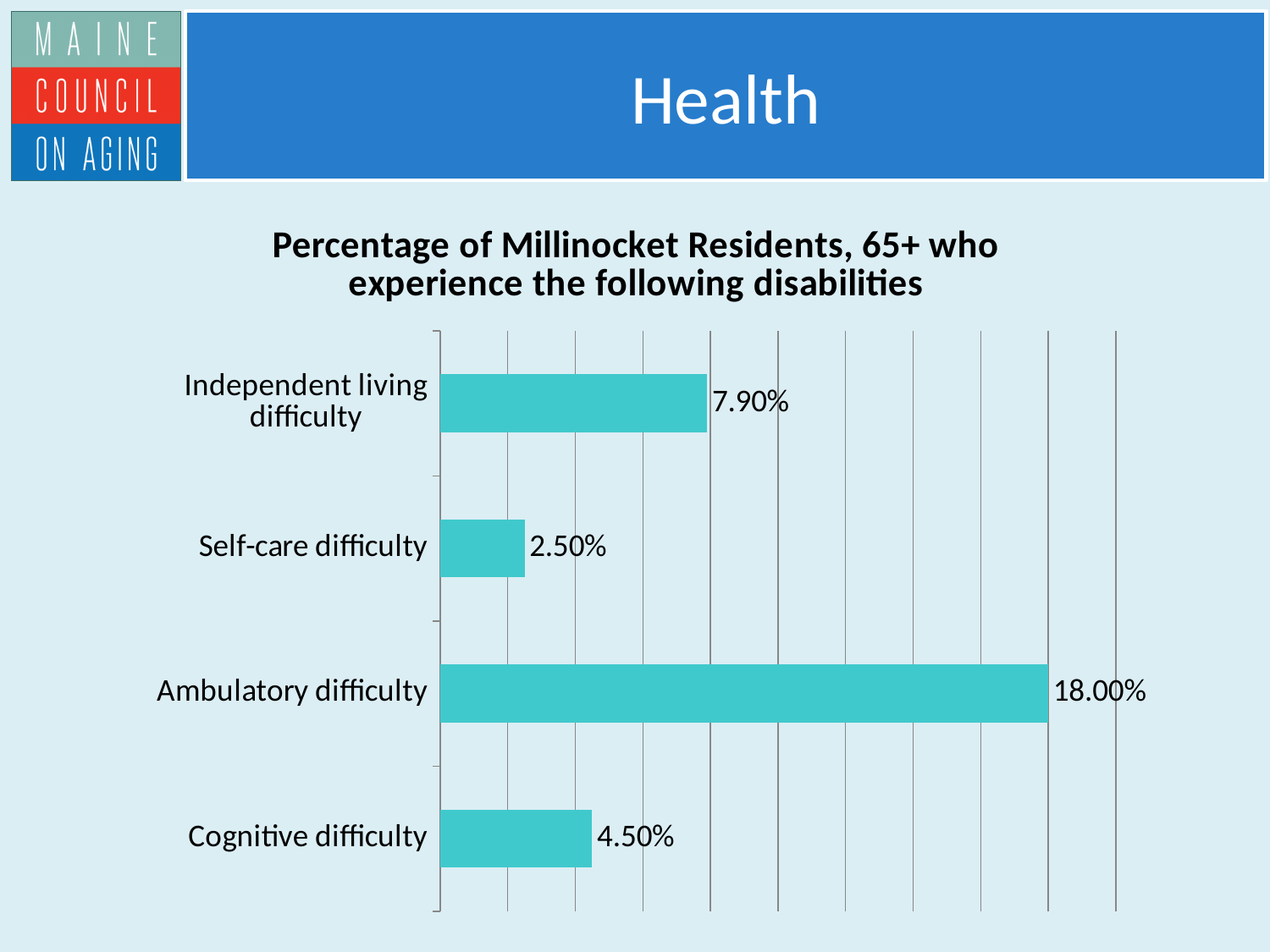
Which disability category has the lowest percentage? Self-care difficulty How many disability categories are shown in the chart? 4 What is the value shown for Cognitive difficulty? 4.50% What is the value shown for Self-care difficulty? 2.50% What is the title of the chart? Percentage of Millinocket Residents, 65+ who experience the following disabilities What is the value shown for Independent living difficulty? 7.90% What percentage of Millinocket residents 65+ experience ambulatory difficulty? 18.00% Which is larger, the value for Independent living difficulty or the value for Cognitive difficulty? Independent living difficulty What is the difference between the percentages for Ambulatory difficulty and Independent living difficulty? 10.10% Which disability category has the highest percentage? Ambulatory difficulty What type of chart is shown on the slide? Bar chart What is the difference between the percentages for Cognitive difficulty and Self-care difficulty? 2.00%